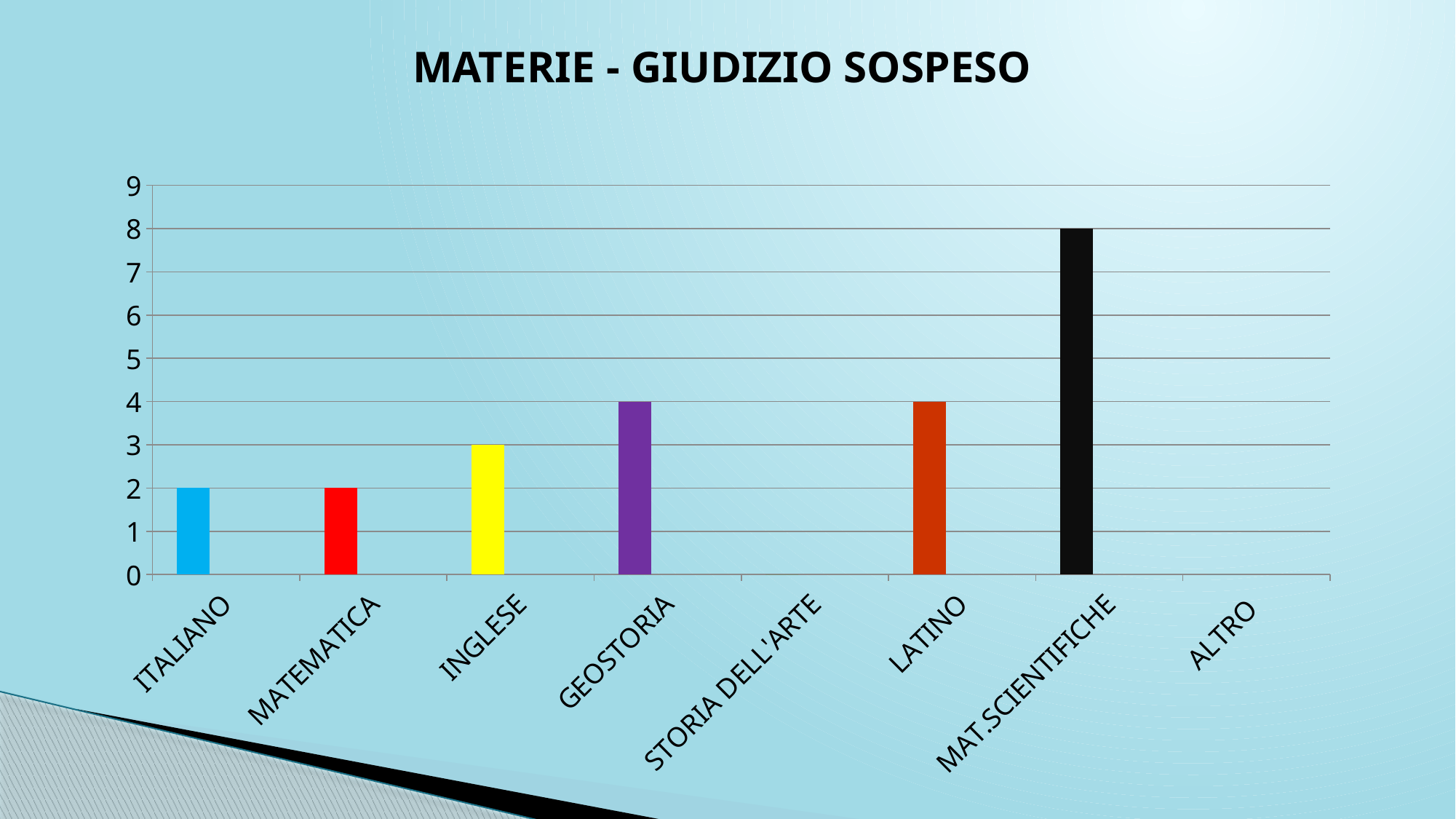
How many categories are shown on the x axis? 8 What is the title of the chart? MATERIE - GIUDIZIO SOSPESO Is the value for MAT.SCIENTIFICHE greater or less than 5? greater What type of chart is shown on the slide? Bar chart What is the value for ITALIANO? 2 What is the value for MAT.SCIENTIFICHE? 8 What is the value for INGLESE? 3 What colour is the bar for MAT.SCIENTIFICHE? Black Which category has the highest value? MAT.SCIENTIFICHE What is the difference between the values for MAT.SCIENTIFICHE and LATINO? 4 What is the value for GEOSTORIA? 4 Which is larger, the value for INGLESE or the value for MATEMATICA? INGLESE